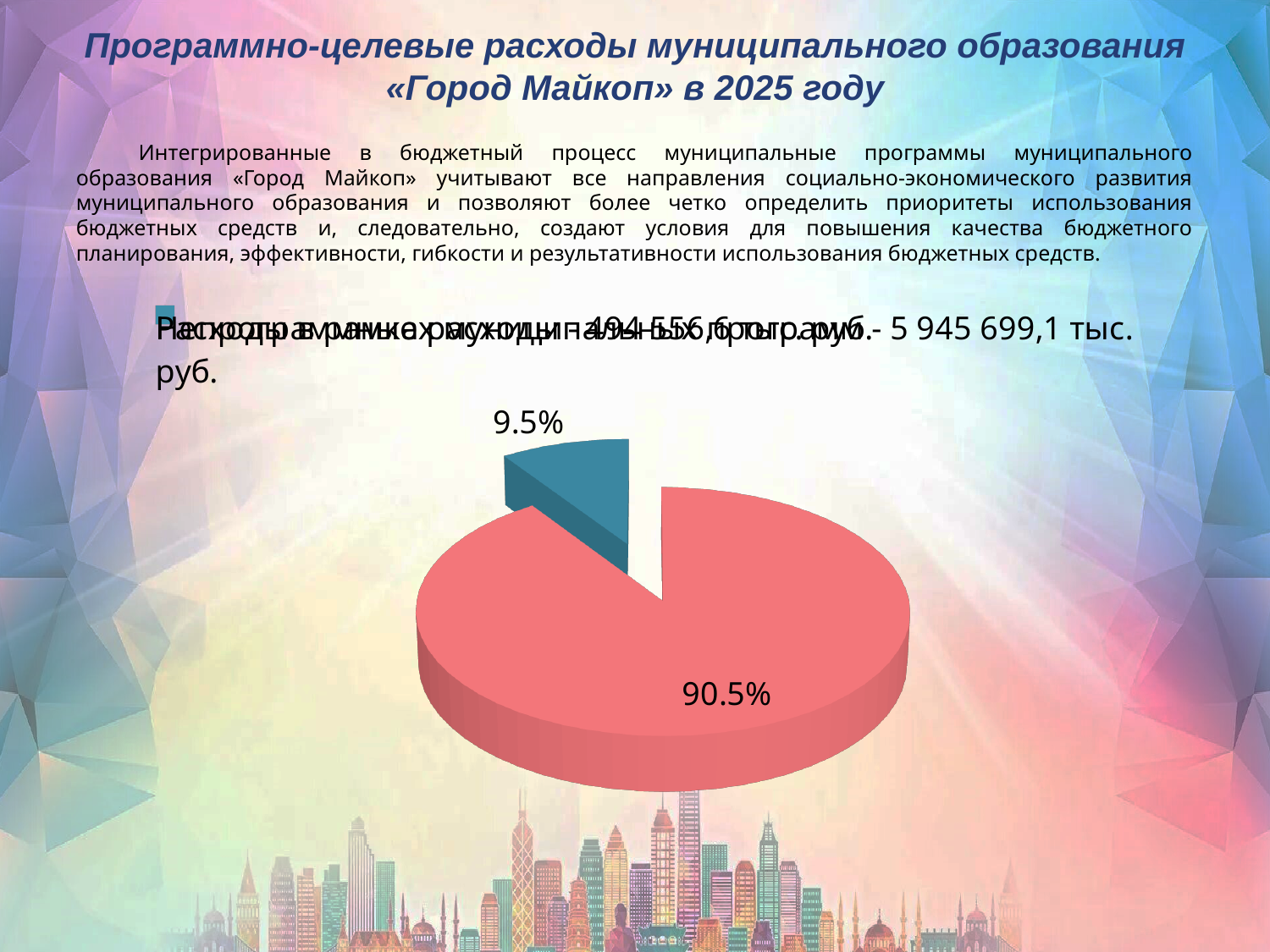
Is the value of the teal slice of the pie chart greater or less than 10%? less What kind of chart is shown on the slide? pie chart What percentage is shown on the large red slice of the pie chart? 90.5% What is the difference in percentage points between the red slice and the teal slice of the pie chart? 81 How many slices does the pie chart have? 2 Which slice of the pie chart is the largest, the red one or the teal one? the red one Is the red slice of the pie chart larger than the teal slice? yes Is the pie chart drawn in 3D? yes Which slice of the pie chart is the smallest, the red one or the teal one? the teal one What share of the pie does the red slice represent? 90.5% What colour is the slice labelled 9.5% in the pie chart? teal What percentage is shown on the small teal slice of the pie chart? 9.5%